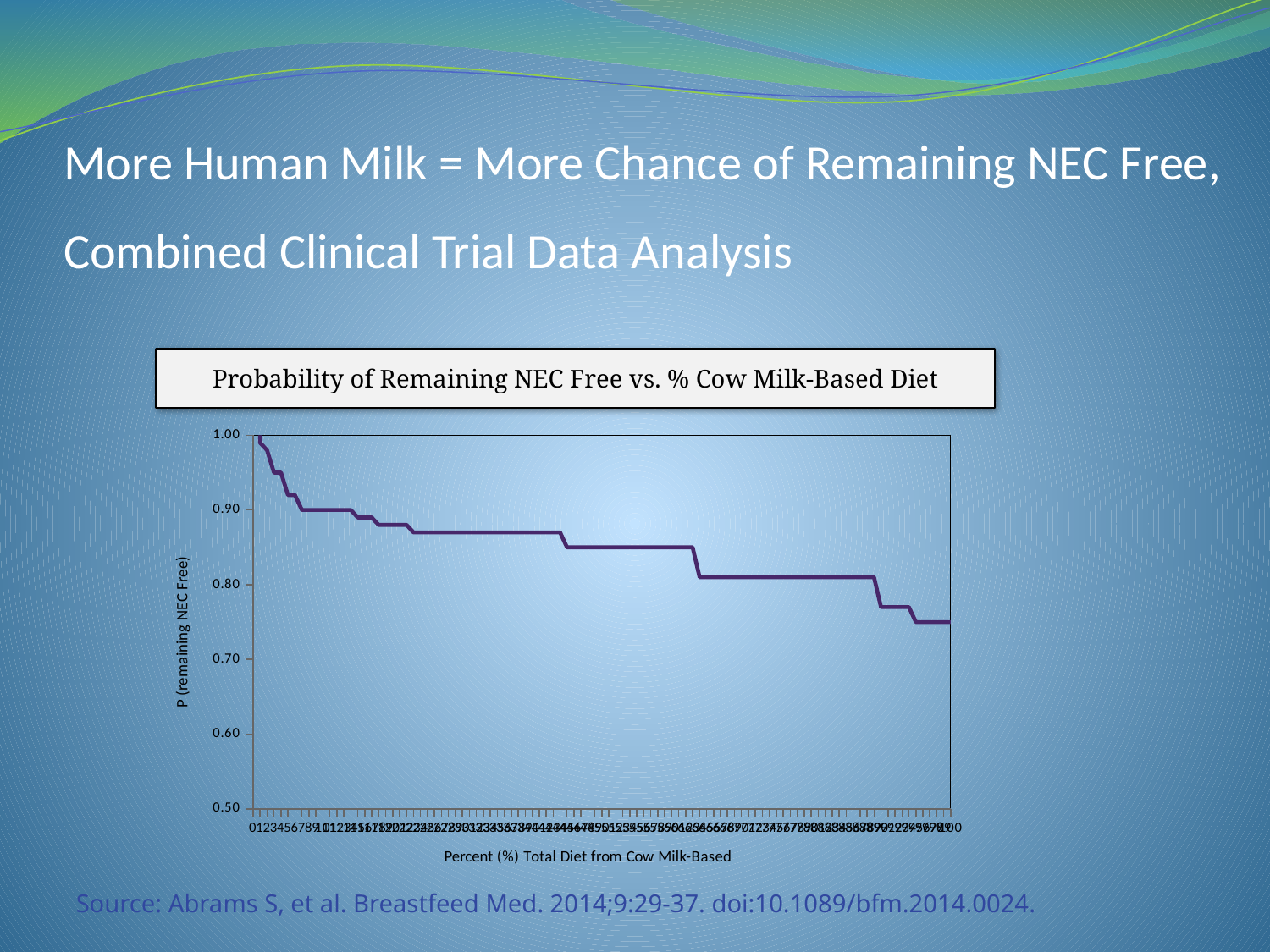
Is the value for 30% cow milk-based diet greater or less than 0.90? less Does the probability of remaining NEC free rise or fall as the percent of diet from cow milk-based increases? fall What is the title of the chart? Probability of Remaining NEC Free vs. % Cow Milk-Based Diet What kind of chart is shown on the slide? line chart What is the label of the y axis? P (remaining NEC Free) Which has the larger probability of remaining NEC free: 10% or 90% cow milk-based diet? 10% Is the value for 50% cow milk-based diet greater or less than 0.80? greater What is the lowest value shown on the y axis? 0.50 Is the value for 100% cow milk-based diet greater or less than 0.80? less